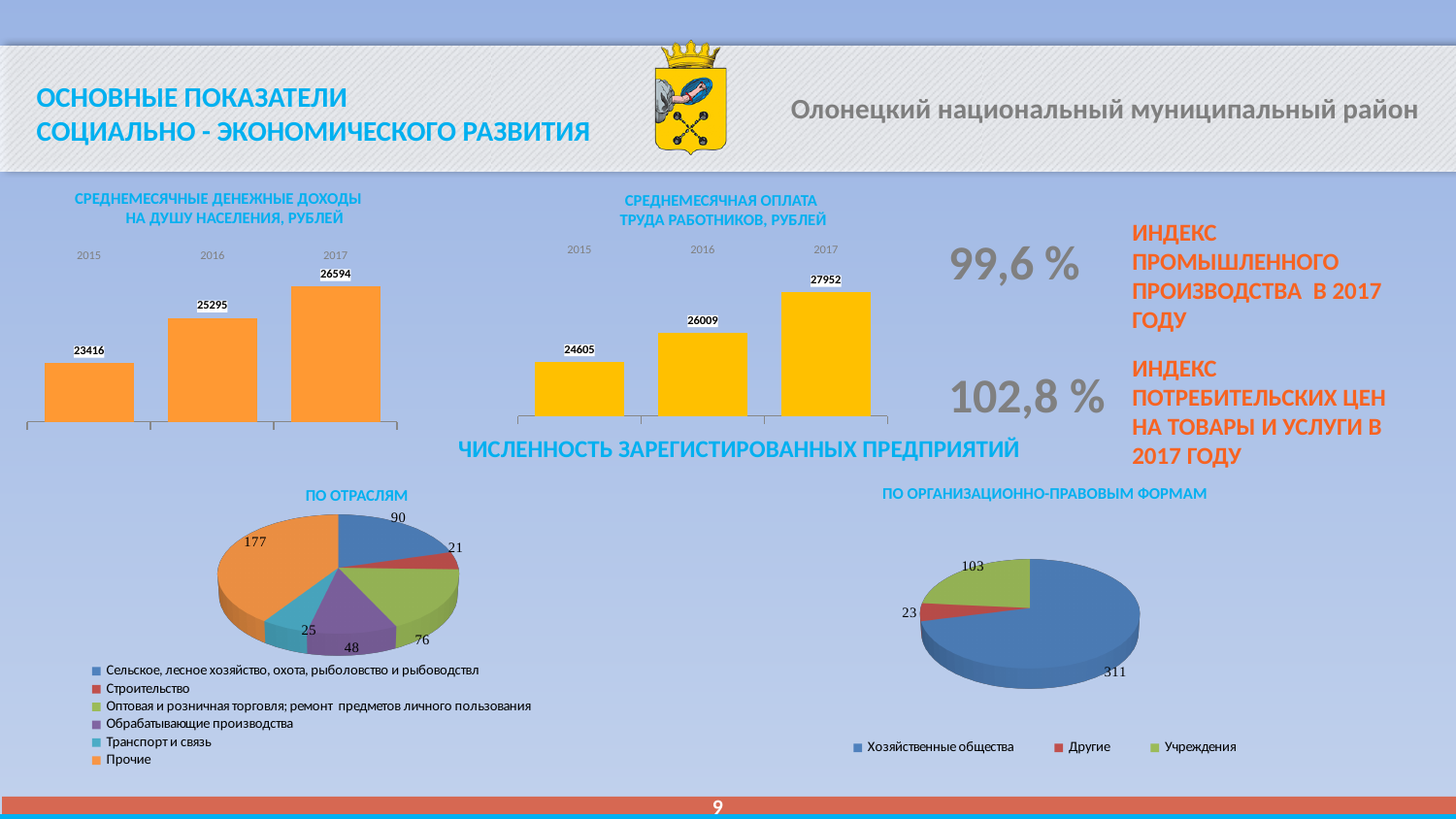
In the pie chart 'По организационно-правовым формам', what is the value for 'Учреждения'? 103 In the pie chart 'По отраслям', which category has the smallest value? Строительство In the chart 'Среднемесячные денежные доходы на душу населения, рублей', what is the value for 2015? 23416 In the pie chart 'По отраслям', what is the value for 'Прочие'? 177 In the chart 'Среднемесячные денежные доходы на душу населения, рублей', what is the difference between the 2017 and 2015 values? 3178 How many categories does the legend of the pie chart 'По отраслям' list? 6 In the chart 'Среднемесячная оплата труда работников, рублей', which year has the highest value? 2017 In the chart 'Среднемесячные денежные доходы на душу населения, рублей', what is the value for 2017? 26594 In the pie chart 'По организационно-правовым формам', which is larger: 'Хозяйственные общества' or 'Другие'? Хозяйственные общества What kind of chart is 'Среднемесячные денежные доходы на душу населения, рублей'? bar chart In the chart 'Среднемесячная оплата труда работников, рублей', do the values rise or fall from 2015 to 2017? rise In the chart 'Среднемесячная оплата труда работников, рублей', what is the value for 2016? 26009